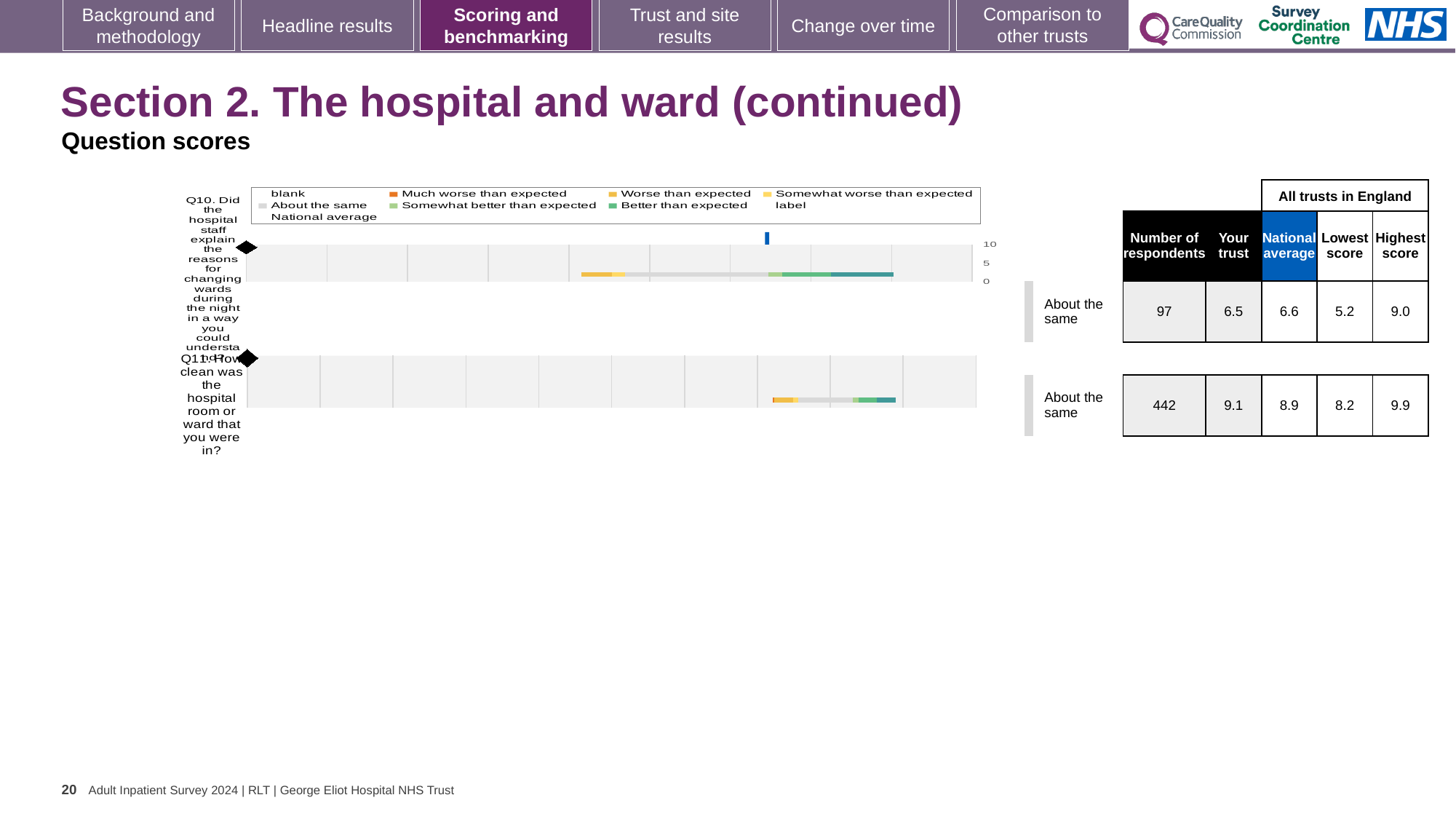
How many survey questions are plotted on the slide? 2 By how much does the national average for Q10 exceed the trust's score for Q10? 0.1 What is the 'Your trust' score for Q10 (explaining reasons for changing wards during the night)? 6.5 Which question has the higher 'Your trust' score, Q10 or Q11? Q11 What is the lowest score among all trusts in England for Q10? 5.2 What benchmark category is shown for Q11? About the same What colour does the legend use for 'Much worse than expected'? orange What is the 'Your trust' score for Q11 (how clean was the hospital room or ward)? 9.1 What is the difference between the highest score and the lowest score for Q11? 1.7 What kind of chart is used to show the question scores for Q10 and Q11? bar chart How many respondents answered Q11? 442 What is the national average score for Q10? 6.6